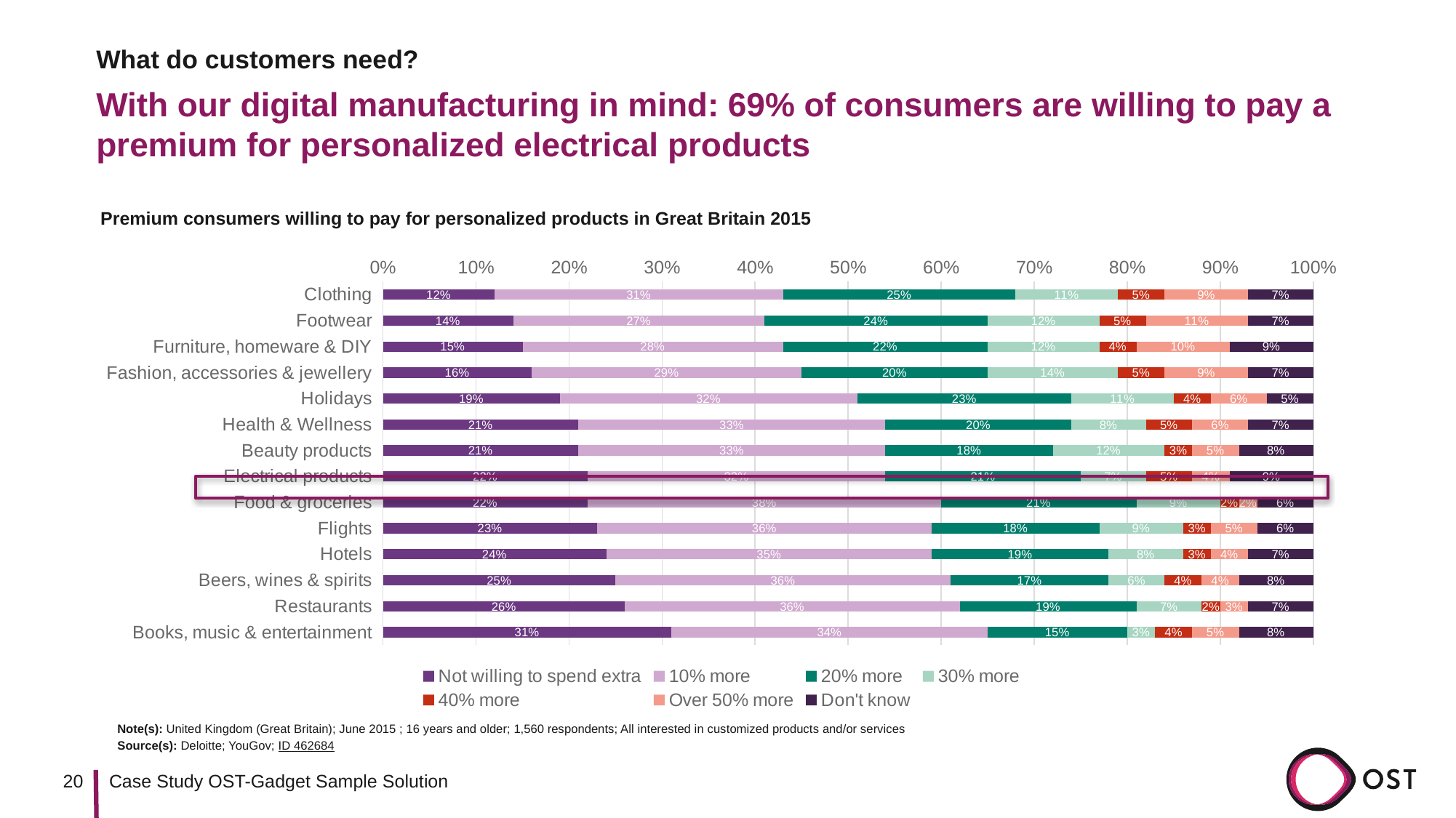
How many series does the legend list? 7 What percentage of consumers would pay 10% more for personalized Food & groceries? 38% What share of consumers are not willing to spend extra for personalized Clothing? 12% What kind of chart is shown on the slide? Stacked bar chart How many product categories are listed on the chart? 14 What is the 'Don't know' value for Furniture, homeware & DIY? 9% Which category has the lowest share of consumers not willing to spend extra? Clothing What is the difference between the 'Not willing to spend extra' values for Books, music & entertainment and Clothing? 19 percentage points What is the 'Over 50% more' value for Footwear? 11% Which has a larger '20% more' share: Clothing or Books, music & entertainment? Clothing What is the title of the chart? Premium consumers willing to pay for personalized products in Great Britain 2015 Which category has the highest share of consumers not willing to spend extra? Books, music & entertainment